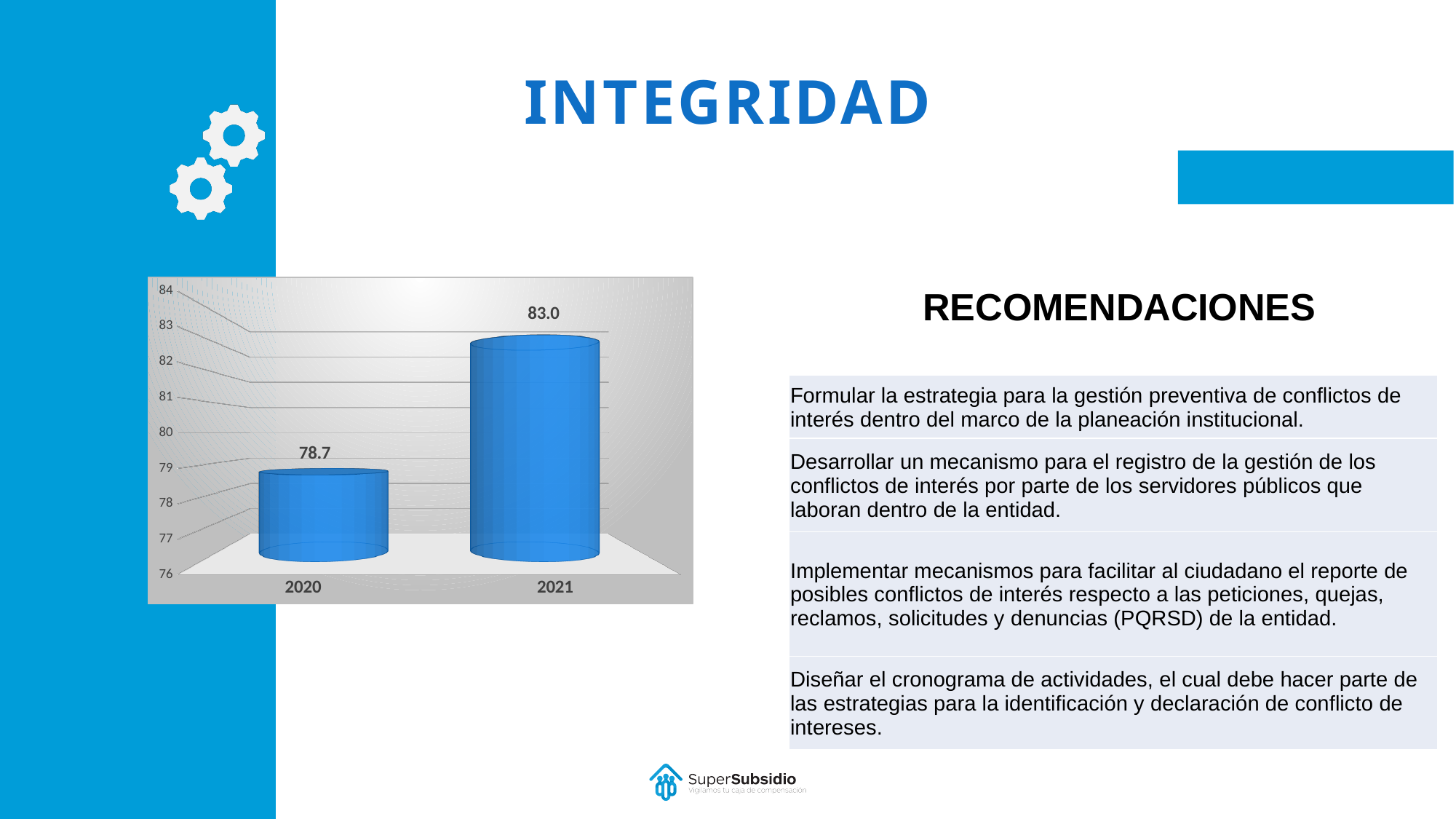
How many categories are shown on the chart? 2 Which is larger, the value for 2020 or the value for 2021? 2021 Which year has the lowest value? 2020 What kind of chart is shown on the slide? bar chart Do the values rise or fall from 2020 to 2021? rise Is the value for 2020 greater or less than 80? less What is the value for 2021? 83.0 Is the value for 2021 greater or less than 82? greater What is the difference between the 2021 and 2020 values? 4.3 What is the value for 2020? 78.7 Which year has the highest value? 2021 What is the lowest value shown on the chart's vertical axis? 76